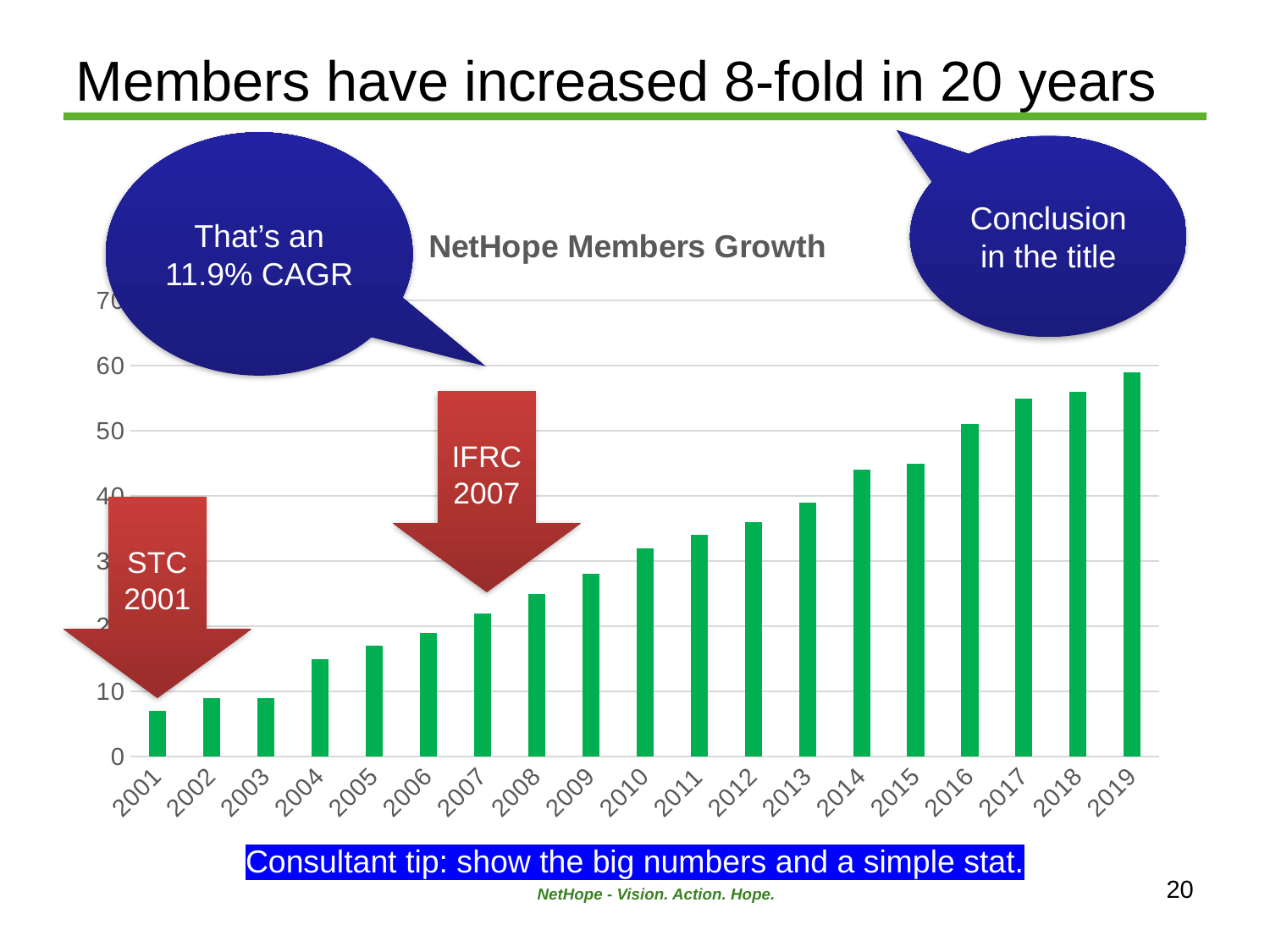
What kind of chart is shown on the slide? bar chart What is the title of the chart? NetHope Members Growth How many years are plotted on the x axis of the chart? 19 Is the value for 2010 greater or less than 30? greater Is the value for 2019 greater or less than 50? greater Which year has the larger value, 2005 or 2015? 2015 Do the values generally rise or fall from 2001 to 2019? rise Is the value for 2001 greater or less than 10? less Which year has the lowest bar in the chart? 2001 Which year has the highest bar in the chart? 2019 What colour are the bars in the chart? green